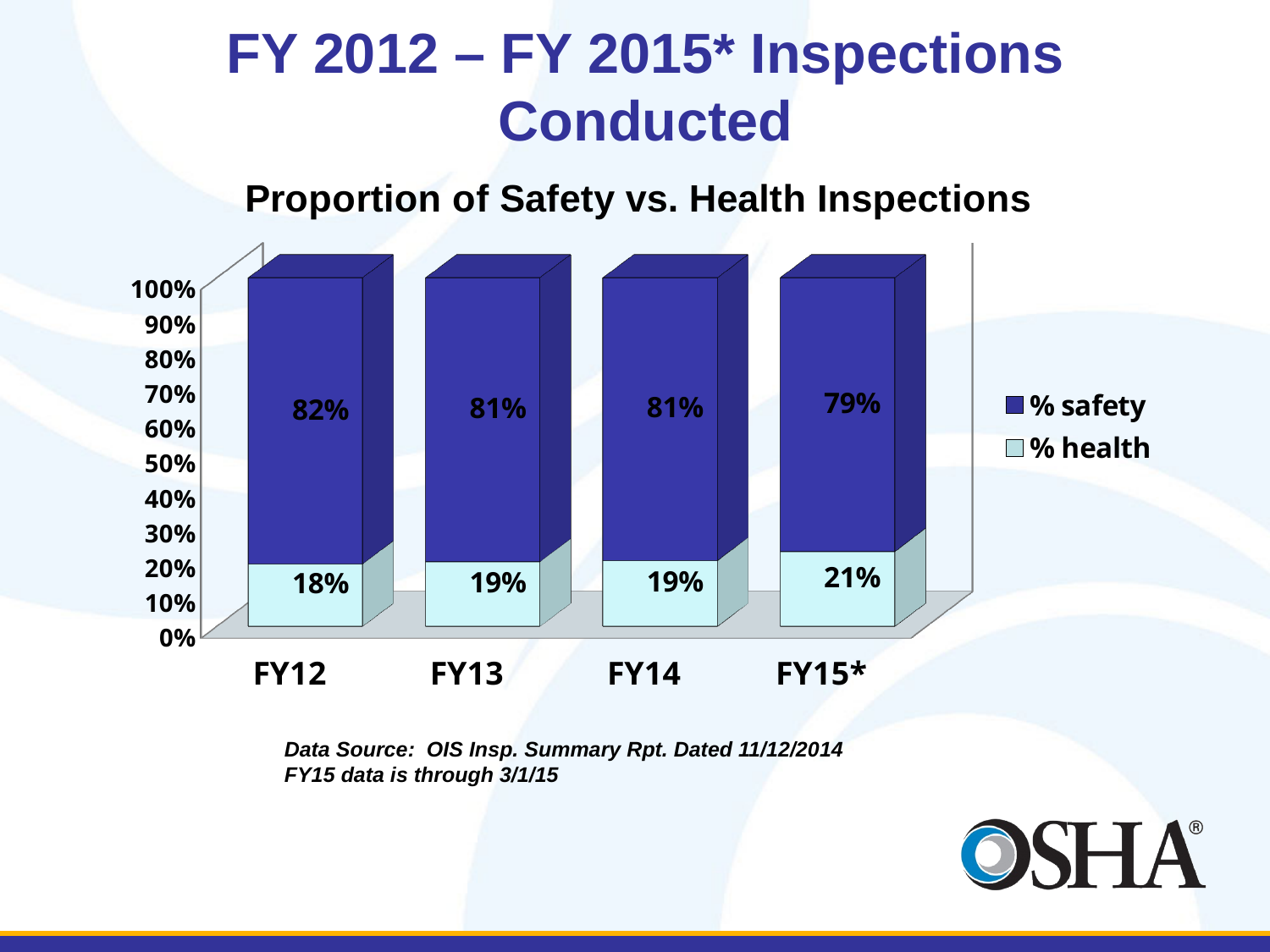
What is the % safety value for FY15*? 79% Which fiscal year has the lowest % health value? FY12 Does the % health value rise or fall from FY12 to FY15*? Rise Which fiscal year has the highest % health value? FY15* What is the % health value for FY13? 19% How many series does the legend list? 2 Which is larger, the % health value for FY12 or for FY14? FY14 What is the difference between the % safety values for FY12 and FY15*? 3% What is the % health value for FY15*? 21% What is the % safety value for FY12? 82% What kind of chart is shown on the slide? Stacked bar chart How many fiscal years are shown on the x axis? 4